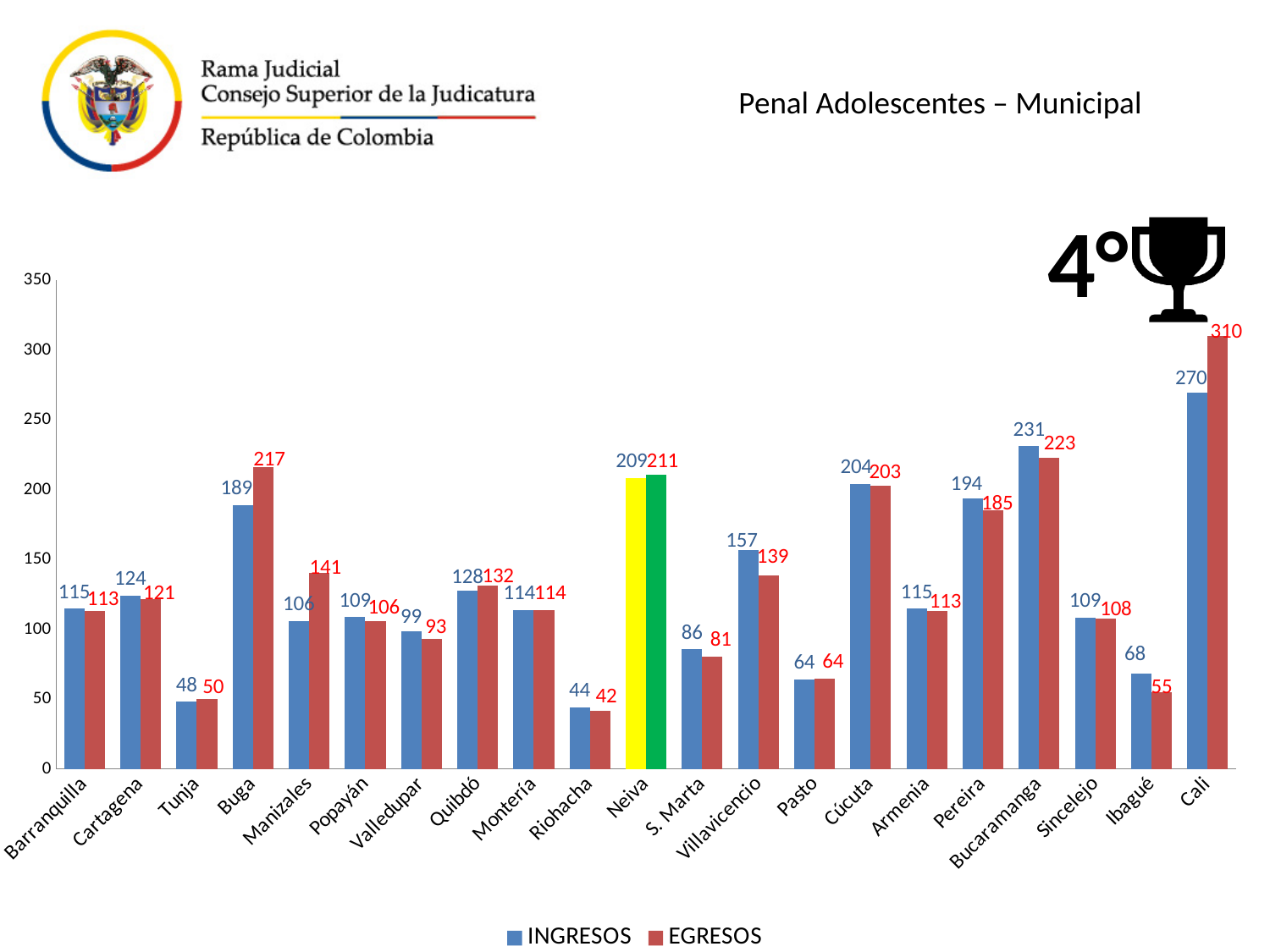
How many series does the legend list? 2 What is the EGRESOS value for Cali? 310 What kind of chart is shown on the slide? bar chart Which city has the highest INGRESOS value? Cali Is the INGRESOS value for Bucaramanga greater or less than 200? greater What is the difference between EGRESOS and INGRESOS for Manizales? 35 What is the title shown above the chart? Penal Adolescentes – Municipal What is the EGRESOS value for Neiva? 211 Which is larger for Villavicencio, INGRESOS or EGRESOS? INGRESOS What is the INGRESOS value for Buga? 189 How many cities are shown on the x axis? 21 Which city has the lowest EGRESOS value? Riohacha